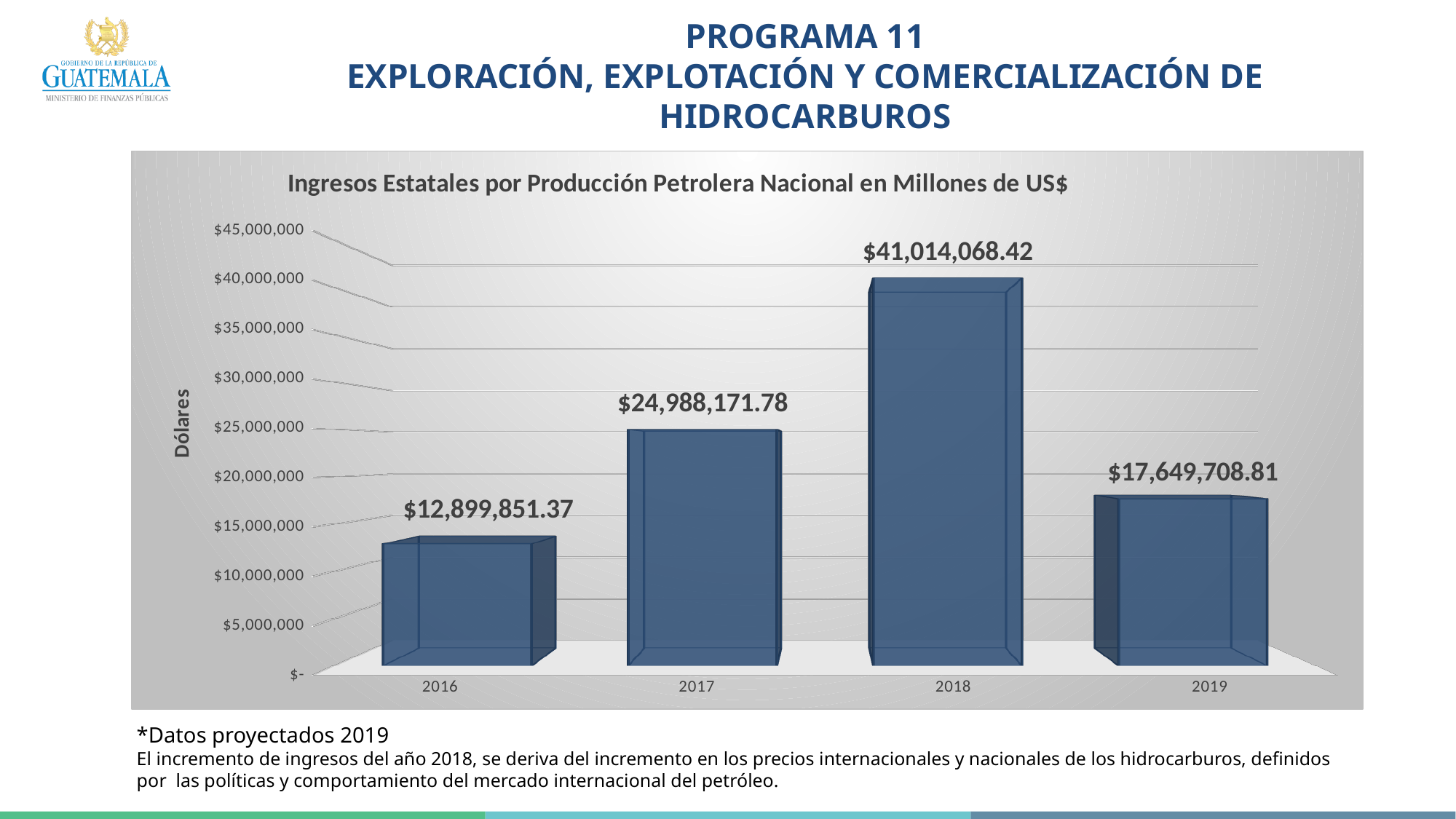
What is the difference between the values for 2018 and 2017? $16,025,896.64 What is the value for 2019? $17,649,708.81 What is the value for 2018? $41,014,068.42 Which year has the lowest value? 2016 Which year has the highest value? 2018 What is the difference between the values for 2019 and 2016? $4,749,857.44 Do the values rise or fall from 2016 to 2018? rise What is the value for 2016? $12,899,851.37 How many years are shown on the x axis? 4 Which is larger, the value for 2017 or the value for 2019? 2017 Is the value for 2017 greater or less than $20,000,000? greater What kind of chart is shown? bar chart